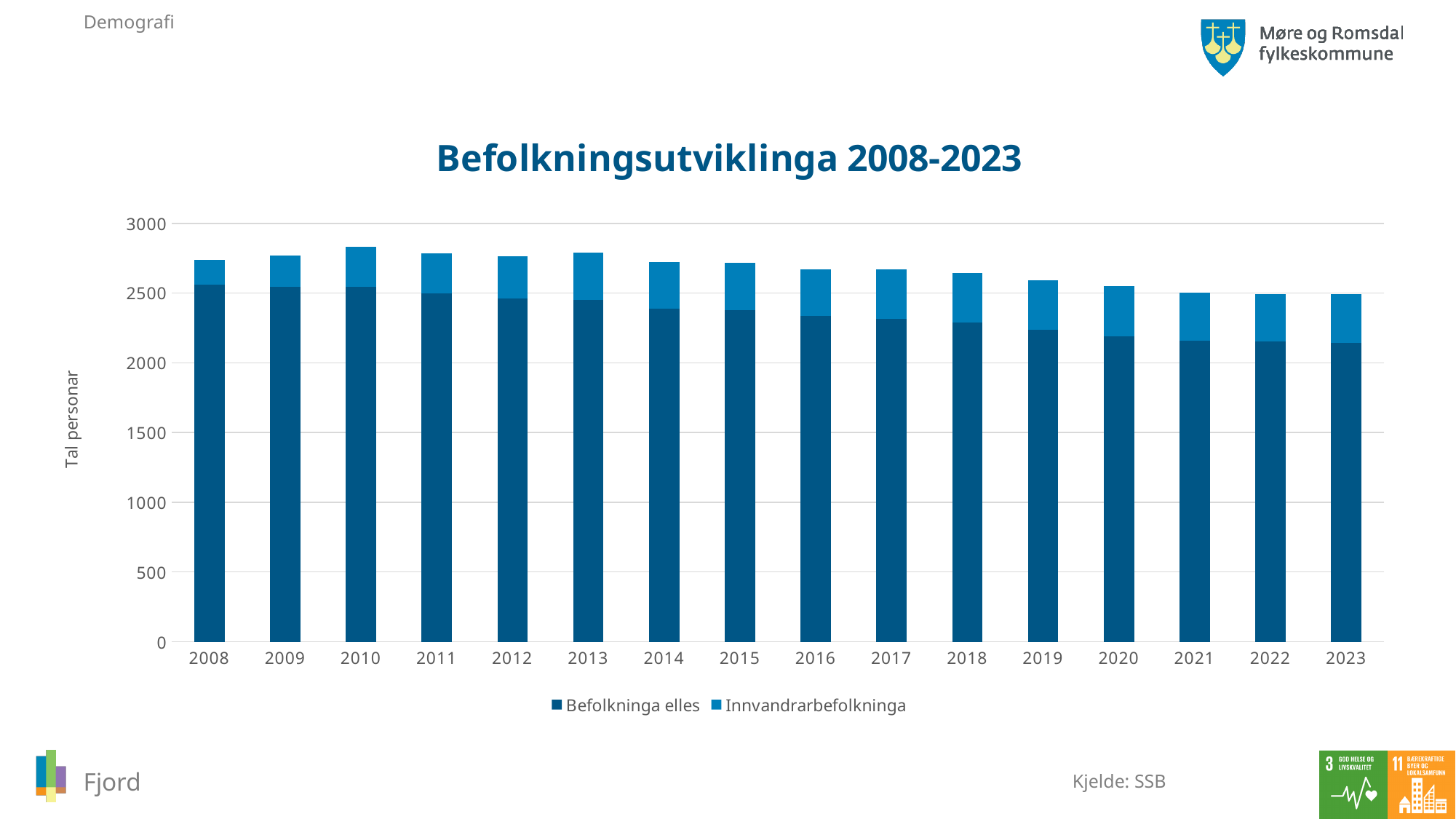
Does the Befolkninga elles series generally rise or fall from 2008 to 2023? fall Is the total bar for 2008 greater or less than 2500? greater Is the total bar for 2010 greater or less than 3000? less How many years are shown on the x axis of the chart? 16 How many series does the legend list? 2 What is the title of the chart? Befolkningsutviklinga 2008-2023 Which year has the tallest total bar? 2010 Which is larger, the Innvandrarbefolkninga segment in 2008 or in 2023? 2023 What kind of chart is shown on the slide? Stacked bar chart Is the value for Befolkninga elles in 2016 greater or less than 2500? less Which is larger, the total bar for 2008 or the total bar for 2023? 2008